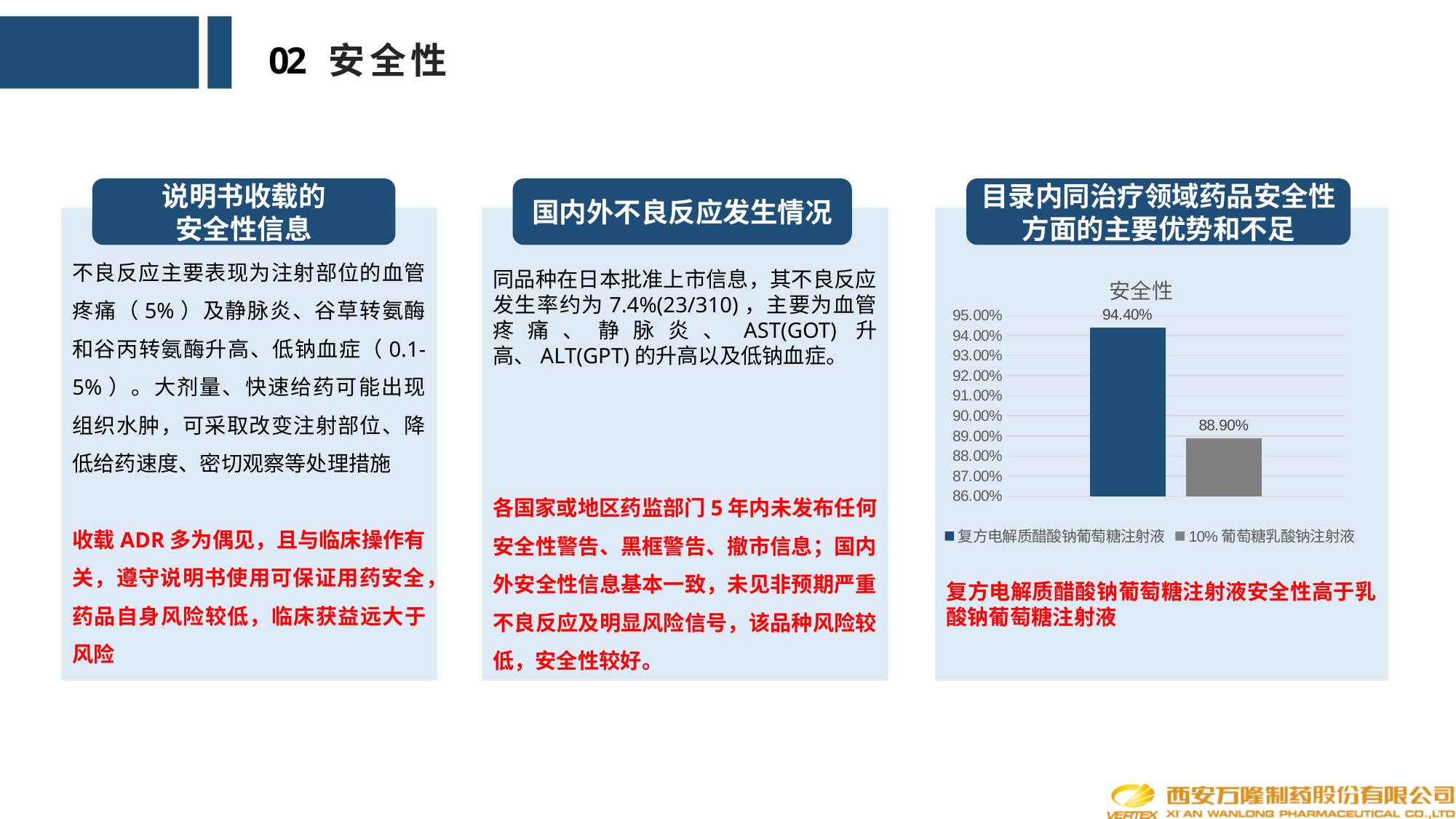
How many series does the legend of the 安全性 chart list? 2 What is the value for 复方电解质醋酸钠葡萄糖注射液 in the 安全性 chart? 94.40% What kind of chart is the 安全性 chart? bar chart In the 安全性 chart, which is larger: the value for 复方电解质醋酸钠葡萄糖注射液 or for 10% 葡萄糖乳酸钠注射液? 复方电解质醋酸钠葡萄糖注射液 Is the value for 10% 葡萄糖乳酸钠注射液 in the 安全性 chart greater or less than 90.00%? less Which series has the highest value in the 安全性 chart? 复方电解质醋酸钠葡萄糖注射液 Which series has the lowest value in the 安全性 chart? 10% 葡萄糖乳酸钠注射液 What is the title of the chart on the slide? 安全性 What is the difference between the values for 复方电解质醋酸钠葡萄糖注射液 and 10% 葡萄糖乳酸钠注射液 in the 安全性 chart? 5.50% Is the value for 复方电解质醋酸钠葡萄糖注射液 in the 安全性 chart greater or less than 93.00%? greater How many bars are plotted in the 安全性 chart? 2 What is the value for 10% 葡萄糖乳酸钠注射液 in the 安全性 chart? 88.90%